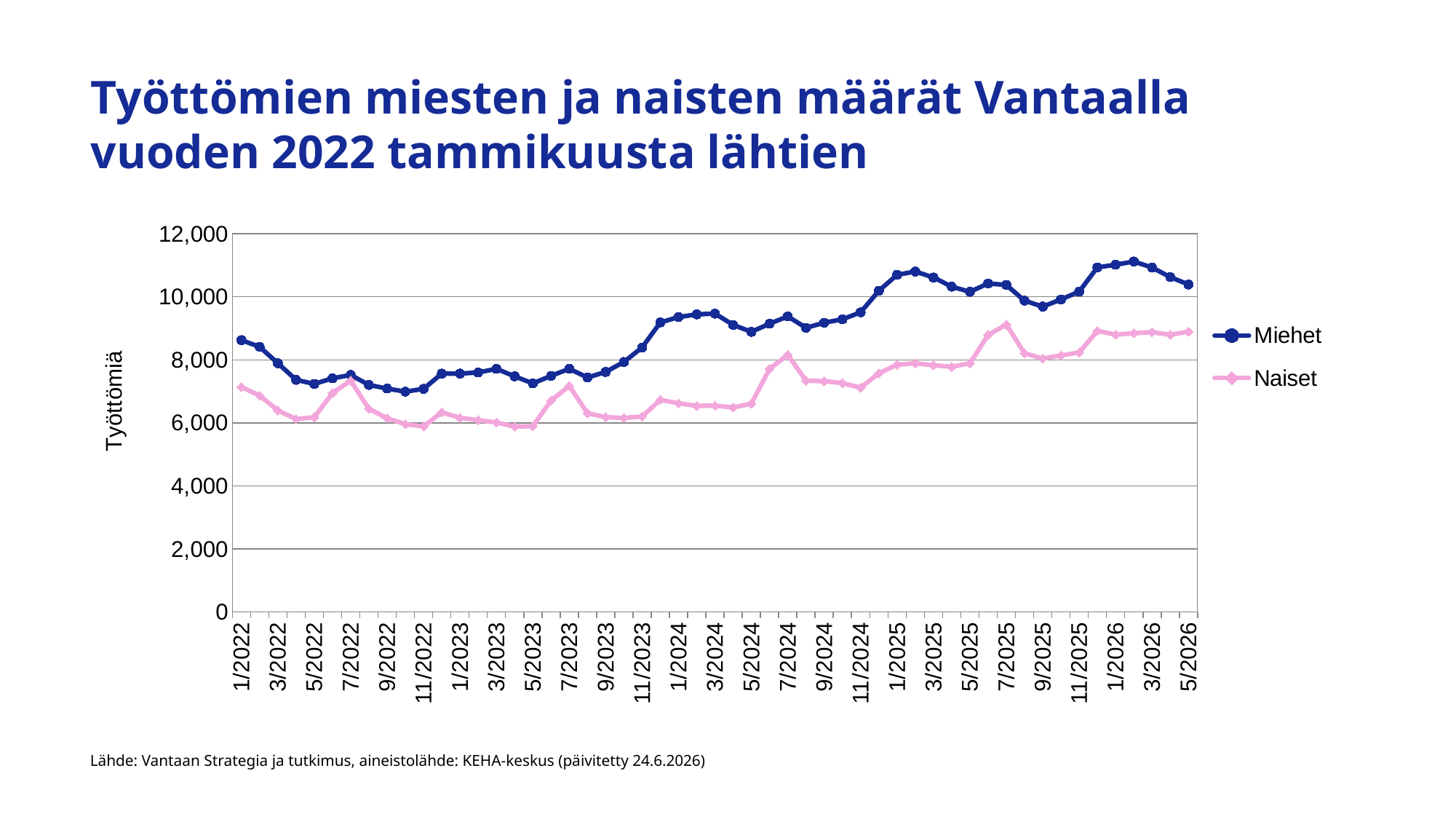
Is the value for Miehet in 1/2022 greater or less than 8,000? greater Is the value for Miehet in 1/2025 greater or less than 10,000? greater What are the two series named in the legend? Miehet and Naiset What is the label on the vertical axis? Työttömiä How many series does the legend list? 2 Is the value for Naiset in 1/2022 greater or less than 8,000? less Which series has the higher value in 5/2026, Miehet or Naiset? Miehet What kind of chart is shown on the slide? Line chart Which series reaches the highest value anywhere on the chart? Miehet Does the Miehet series overall rise or fall from 1/2022 to 5/2026? Rise